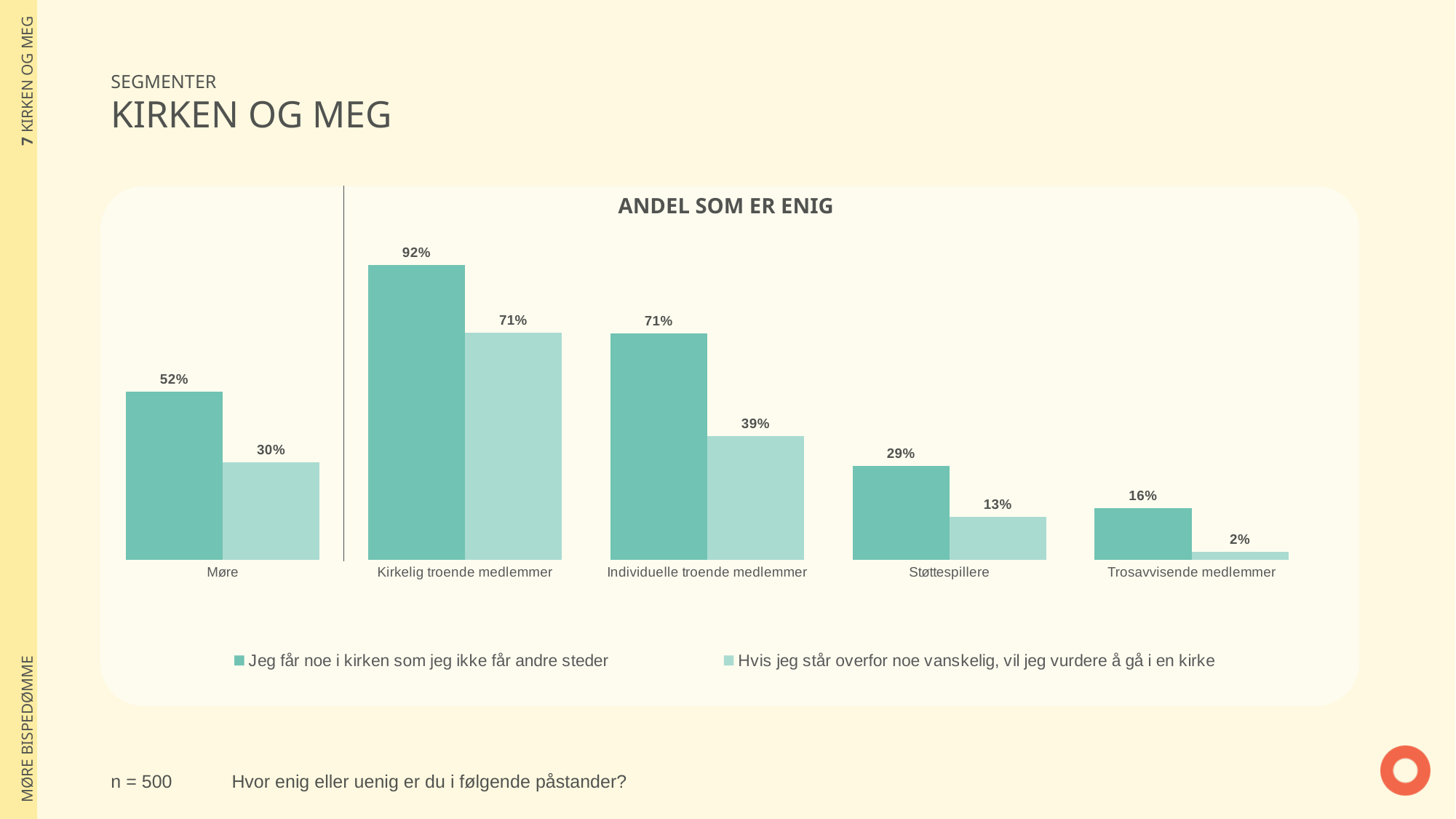
What is the value for Støttespillere in the series "Hvis jeg står overfor noe vanskelig, vil jeg vurdere å gå i en kirke"? 13% What kind of chart is shown on the slide? Bar chart What is the value for Individuelle troende medlemmer in the series "Hvis jeg står overfor noe vanskelig, vil jeg vurdere å gå i en kirke"? 39% How many series does the legend list? 2 How many categories are shown on the x axis? 5 What is the value for Møre in the series "Jeg får noe i kirken som jeg ikke får andre steder"? 52% Which category has the lowest value in the series "Hvis jeg står overfor noe vanskelig, vil jeg vurdere å gå i en kirke"? Trosavvisende medlemmer Which category has the highest value in the series "Jeg får noe i kirken som jeg ikke får andre steder"? Kirkelig troende medlemmer Which is larger for Trosavvisende medlemmer: "Jeg får noe i kirken som jeg ikke får andre steder" or "Hvis jeg står overfor noe vanskelig, vil jeg vurdere å gå i en kirke"? Jeg får noe i kirken som jeg ikke får andre steder What is the difference between the values for Møre and Støttespillere in the series "Jeg får noe i kirken som jeg ikke får andre steder"? 23 percentage points What is the title of the chart? ANDEL SOM ER ENIG What is the difference between the two series values for Kirkelig troende medlemmer? 21 percentage points